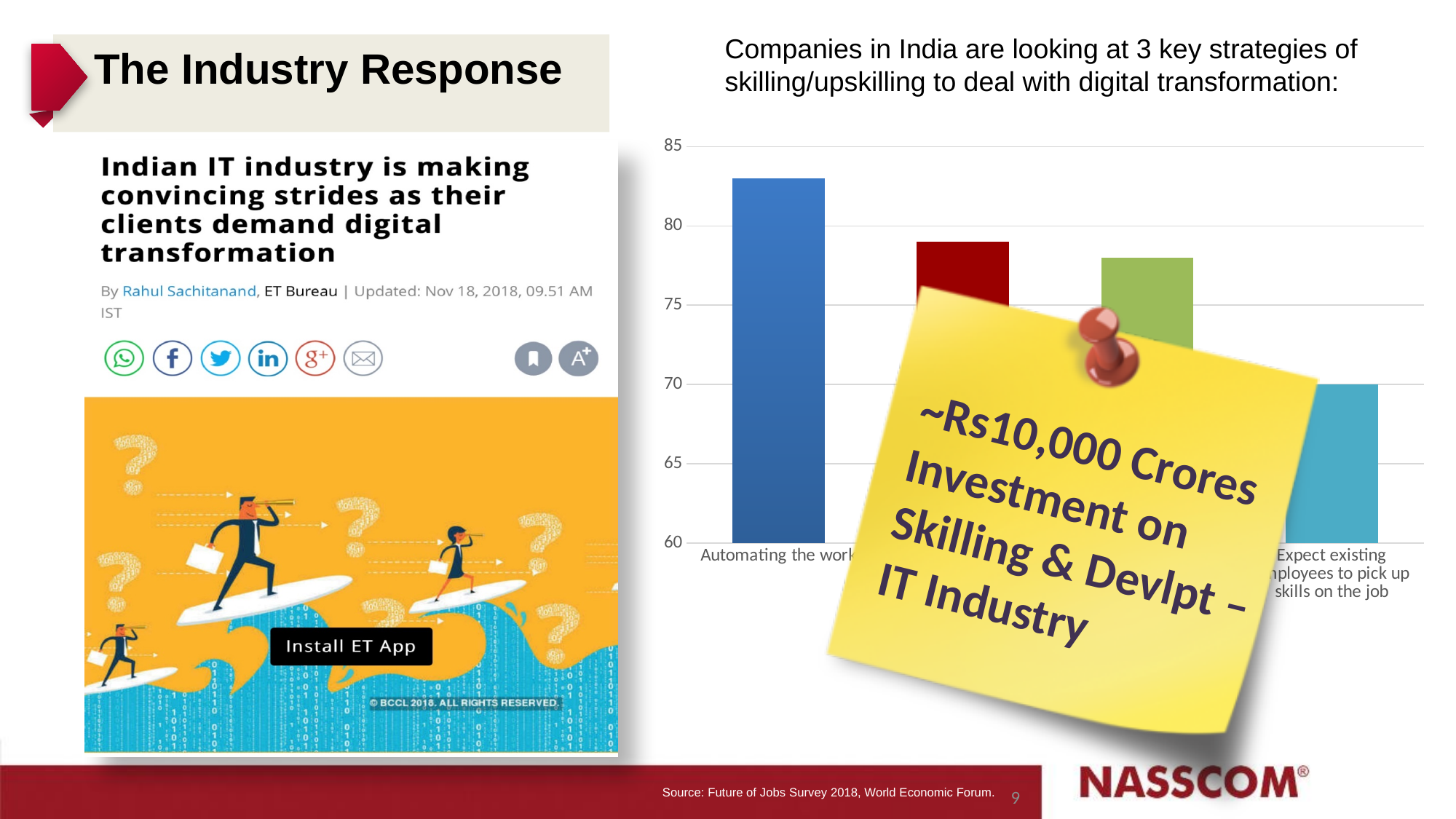
What is the highest tick value shown on the chart's vertical axis? 85 Is the value of the first (blue) bar greater or less than 80? greater Which bar in the chart is the tallest? the first (blue) bar, Automating the work Which is larger, the first (blue) bar or the last (teal) bar? the first (blue) bar What kind of chart is shown on the right side of the slide? bar chart Which bar in the chart is the shortest? the last (teal) bar, Expect existing employees to pick up skills on the job Is the value of the last (teal) bar greater or less than 75? less Is the value of the third (green) bar greater or less than 80? less What is the lowest tick value shown on the chart's vertical axis? 60 Do the bar values rise or fall from left to right across the chart? fall How many bars does the chart on the right side of the slide have? 4